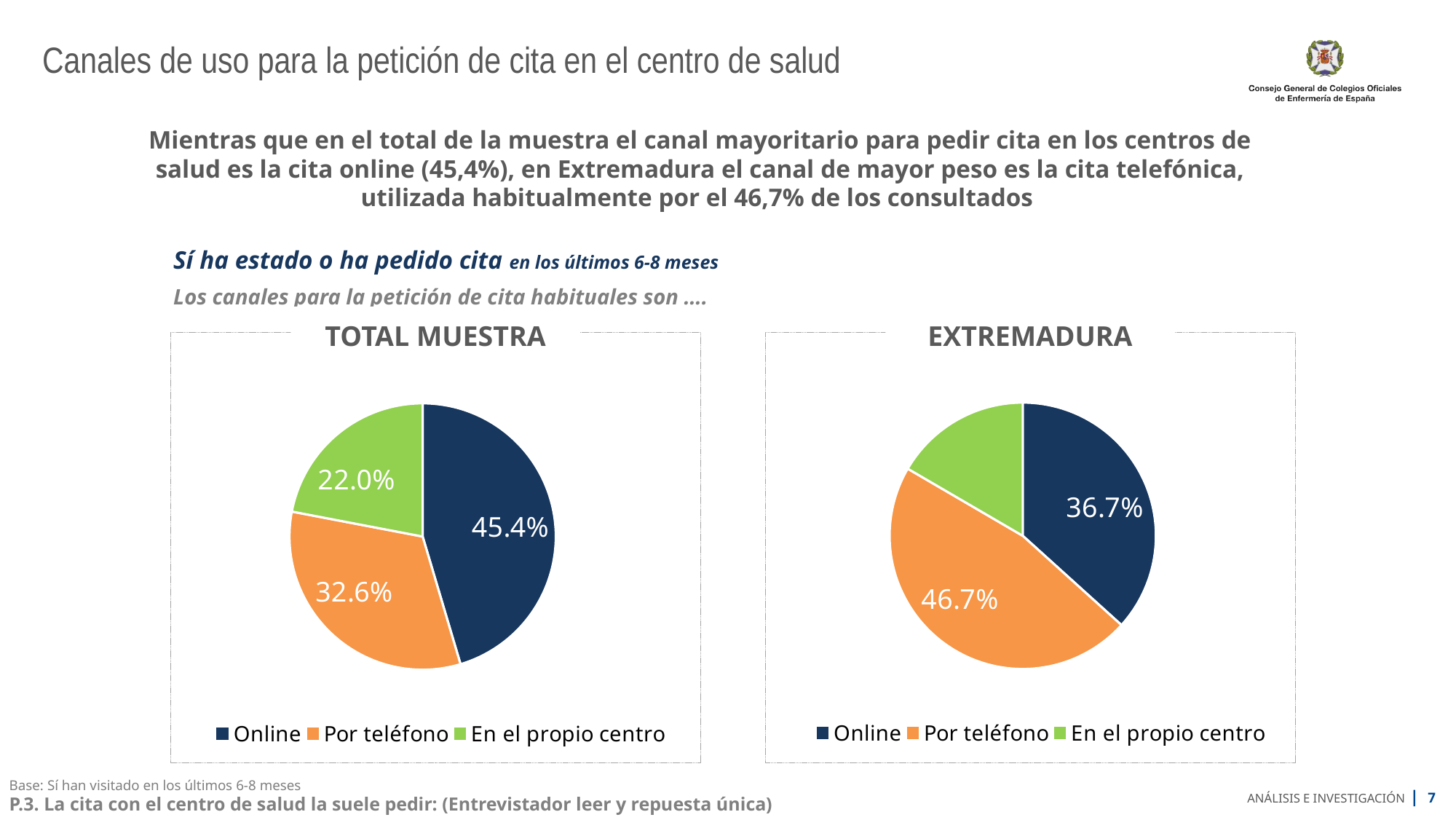
In the TOTAL MUESTRA chart, what percentage is shown for En el propio centro? 22.0% In the TOTAL MUESTRA chart, what is the difference in percentage points between Online and Por teléfono? 12.8 In the EXTREMADURA chart, what percentage is shown for Por teléfono? 46.7% In the TOTAL MUESTRA chart, what percentage is shown for Por teléfono? 32.6% In the TOTAL MUESTRA chart, what percentage is shown for Online? 45.4% In the EXTREMADURA chart, what percentage is shown for Online? 36.7% In the EXTREMADURA chart, what is the difference in percentage points between Por teléfono and Online? 10.0 In the TOTAL MUESTRA chart, which channel has the largest share? Online What kind of chart is the TOTAL MUESTRA chart? Pie chart In the EXTREMADURA chart, which channel has the smallest share? En el propio centro How many categories does the legend of the EXTREMADURA chart list? 3 In the EXTREMADURA chart, which channel has the largest share? Por teléfono